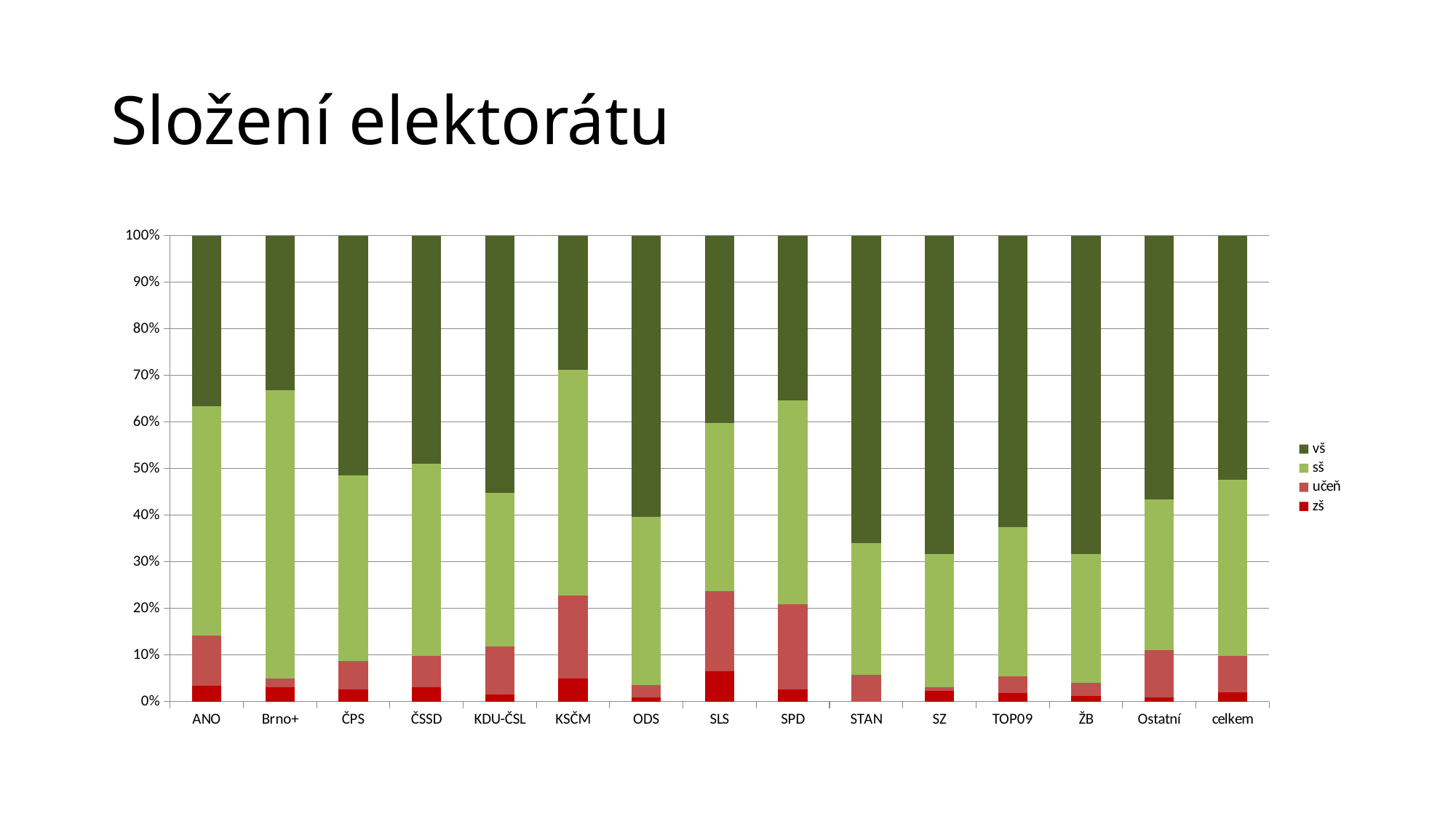
What is the title of the slide containing the chart? Složení elektorátu Is the zš share for SLS greater or less than 10%? less Which has the larger vš share, ODS or ANO? ODS Is the vš share for KSČM greater or less than 40%? less How many categories are shown along the x axis of the chart? 15 Which category has the largest sš share? Brno+ Which series is shown in the darkest green at the top of each bar? vš Which category has the smallest vš share? KSČM What kind of chart is shown on the slide? stacked bar chart Which category has the largest zš share? SLS Is the vš share for STAN greater or less than 60%? greater How many series does the legend list? 4